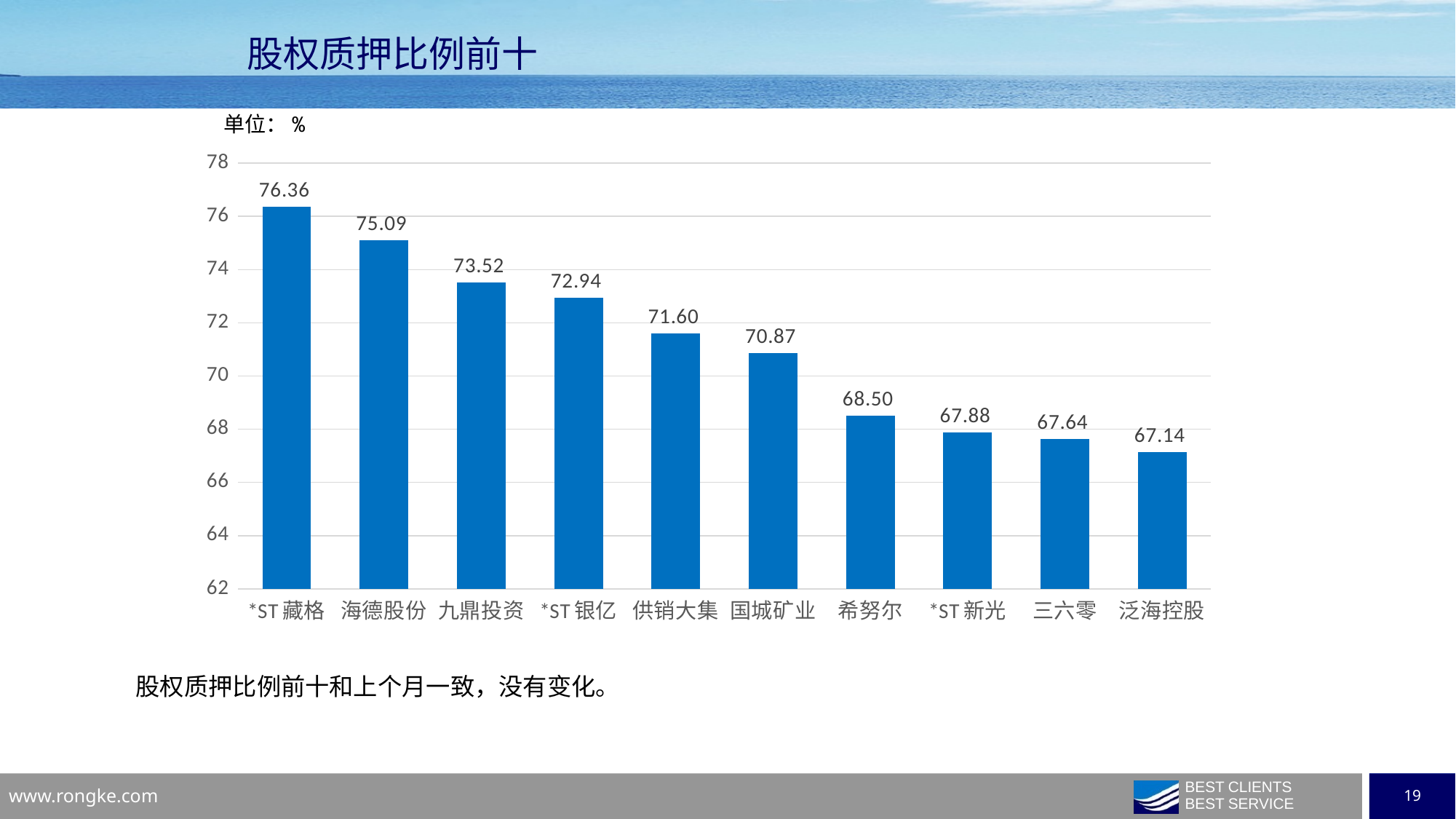
What is the value for 海德股份? 75.09 Which category has the lowest value? 泛海控股 What kind of chart is shown on the slide? bar chart Which is larger, the value for 国城矿业 or the value for 希努尔? 国城矿业 Which category has the highest value? *ST 藏格 Do the values rise or fall from left to right along the x axis? fall What is the value for 供销大集? 71.60 Is the value for *ST 新光 greater or less than 70? less What is the difference between the values for 九鼎投资 and *ST 银亿? 0.58 What is the value for 三六零? 67.64 How many categories are shown in the chart? 10 What is the difference between the values for *ST 藏格 and 泛海控股? 9.22